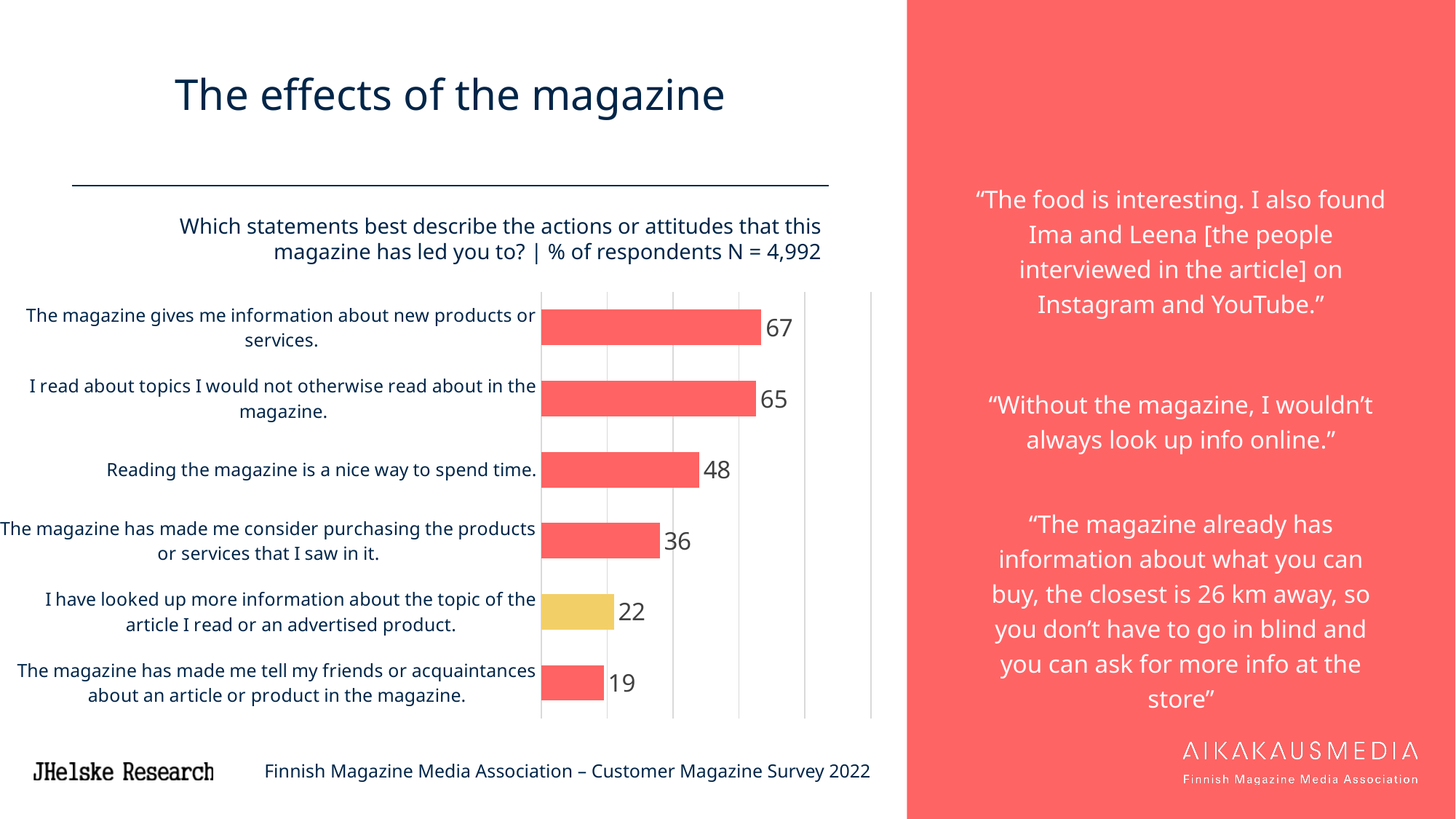
What type of chart is shown on the slide? Bar chart What is the number of respondents (N) stated in the chart's subtitle? 4,992 Which statement has the lowest value in the chart? The magazine has made me tell my friends or acquaintances about an article or product in the magazine. What is the difference between the value for "I read about topics I would not otherwise read about in the magazine." and the value for "The magazine has made me consider purchasing the products or services that I saw in it."? 29 What percentage of respondents said they have looked up more information about the topic of the article they read or an advertised product? 22 What is the value for "Reading the magazine is a nice way to spend time."? 48 How many statements (bars) are shown in the chart? 6 Which bar in the chart is coloured yellow rather than red? I have looked up more information about the topic of the article I read or an advertised product. Which statement has the highest value in the chart? The magazine gives me information about new products or services. Which is larger: the value for "Reading the magazine is a nice way to spend time." or the value for "The magazine has made me consider purchasing the products or services that I saw in it."? Reading the magazine is a nice way to spend time. What is the difference between the highest and lowest values in the chart? 48 What percentage of respondents said the magazine gives them information about new products or services? 67